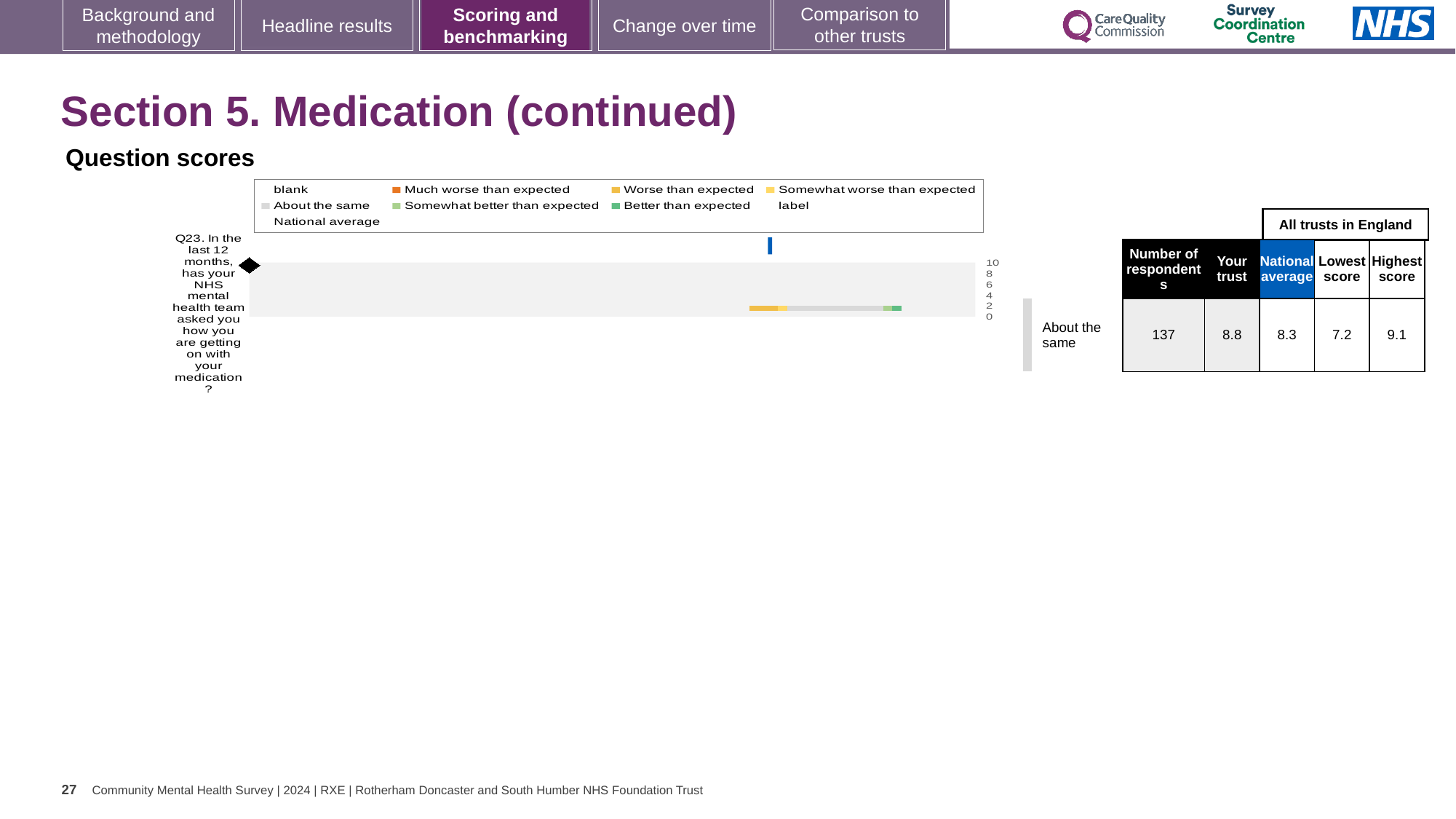
How many entries does the legend of the Question scores chart list? 9 In the table beside the chart, what is the national average score for Q23? 8.3 For Q23, is the "Your trust" score higher or lower than the national average score shown in the table? higher Which question is plotted in the Question scores chart? Q23. In the last 12 months, has your NHS mental health team asked you how you are getting on with your medication? In the table beside the chart, what is the highest score among all trusts in England for Q23? 9.1 What kind of chart is shown under the heading "Question scores"? bar chart In the table beside the chart, what is the number of respondents for Q23? 137 In the table beside the chart, what is the "Your trust" score for Q23? 8.8 What benchmark category is shown for Q23 next to the chart? About the same How many questions (categories) are plotted in the Question scores chart? 1 In the table beside the chart, what is the lowest score among all trusts in England for Q23? 7.2 In the legend of the Question scores chart, what colour represents "Much worse than expected"? orange